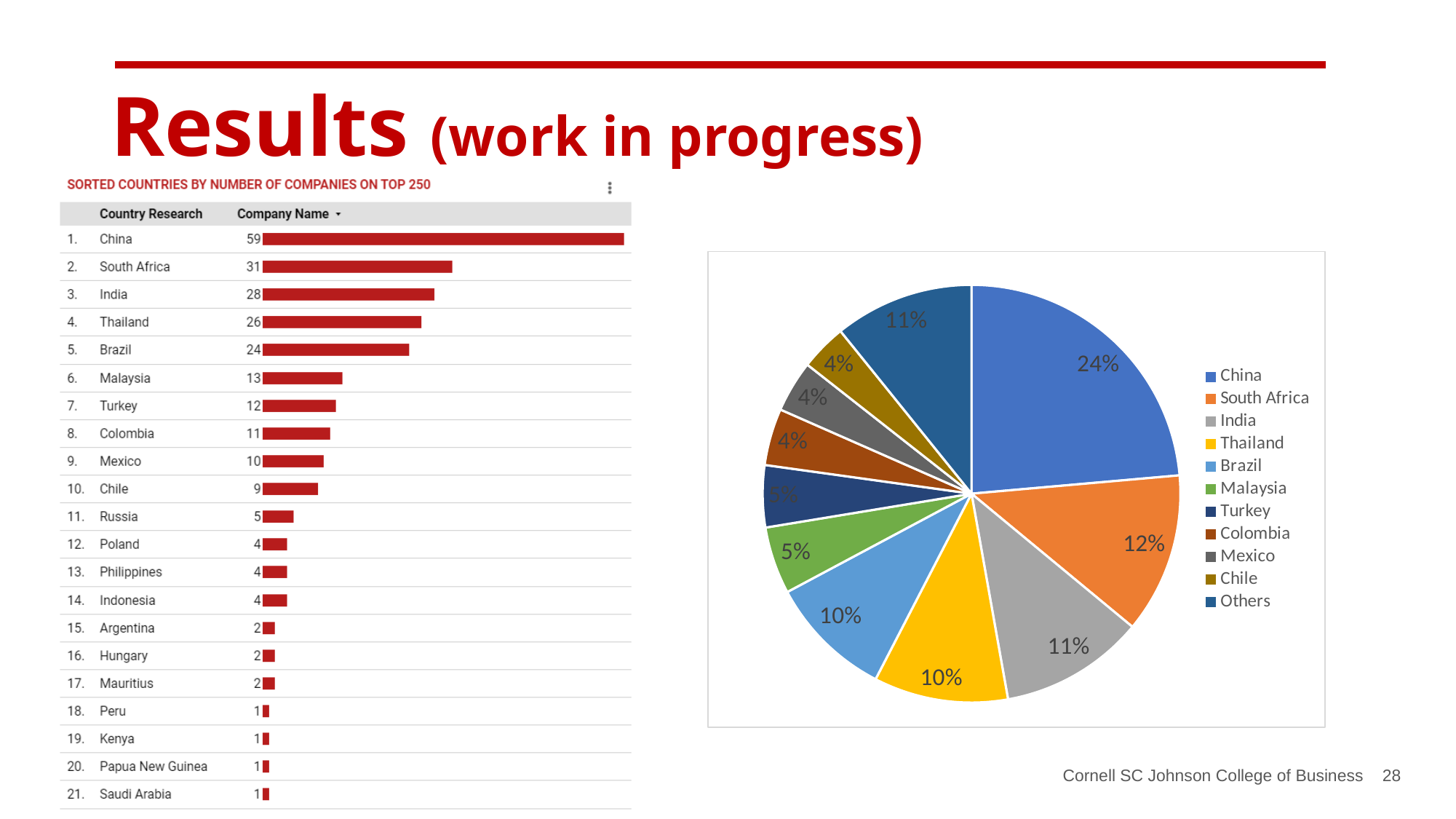
In the chart titled 'Sorted countries by number of companies on top 250', how many companies does China have? 59 What kind of chart is shown on the left side of the slide? Bar chart What kind of chart is shown on the right side of the slide? Pie chart In the pie chart, which country has the largest slice? China In the chart titled 'Sorted countries by number of companies on top 250', which has more companies, India or Thailand? India In the pie chart, what share does Thailand have? 10% In the pie chart, what share does China have? 24% In the chart titled 'Sorted countries by number of companies on top 250', what is the difference between China and South Africa? 28 In the chart titled 'Sorted countries by number of companies on top 250', how many companies does Brazil have? 24 How many countries are listed in the chart titled 'Sorted countries by number of companies on top 250'? 21 In the pie chart, what share does South Africa have? 12% How many entries does the legend of the pie chart list? 11